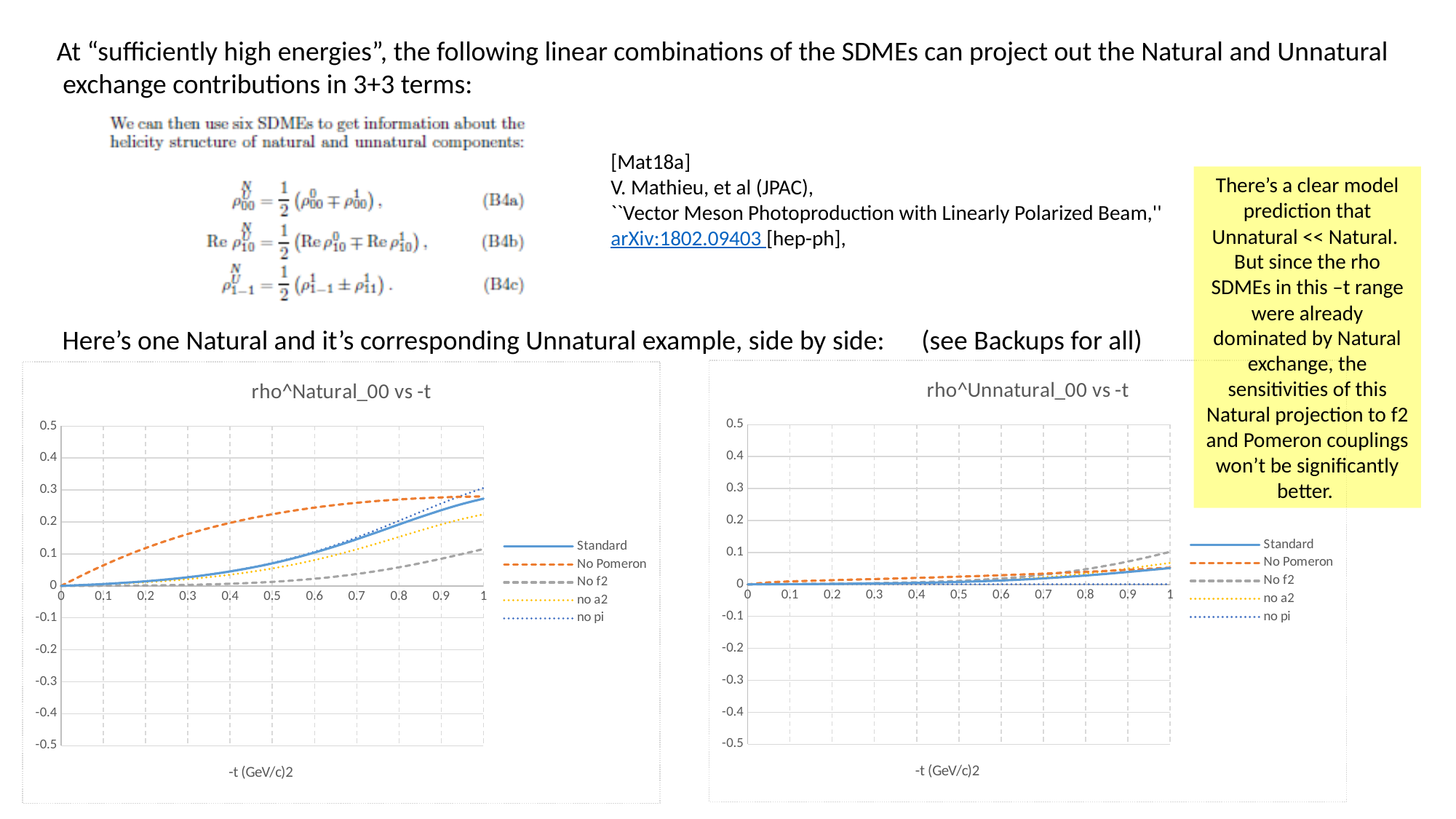
In the right chart "rho^Unnatural_00 vs -t", which series has the lowest value at -t = 1? no pi In the left chart "rho^Natural_00 vs -t", which series has the highest value at -t = 0.5? No Pomeron In the left chart "rho^Natural_00 vs -t", is the value of the Standard series at -t = 1 greater or less than 0.2? greater What is the x-axis label of the left chart "rho^Natural_00 vs -t"? -t (GeV/c)2 In the left chart "rho^Natural_00 vs -t", which series has the lowest value at -t = 1? No f2 What kind of chart is the left chart titled "rho^Natural_00 vs -t"? line chart In the left chart "rho^Natural_00 vs -t", does the Standard series rise or fall as -t increases from 0 to 1? rise How many series does the legend of the left chart "rho^Natural_00 vs -t" list? 5 In the right chart "rho^Unnatural_00 vs -t", is the value of the Standard series at -t = 1 greater or less than 0.1? less In the left chart "rho^Natural_00 vs -t", at -t = 0.5, which is larger: the No Pomeron series or the No f2 series? No Pomeron What is the title of the right chart? rho^Unnatural_00 vs -t In the left chart "rho^Natural_00 vs -t", is the value of the No f2 series at -t = 1 greater or less than 0.2? less